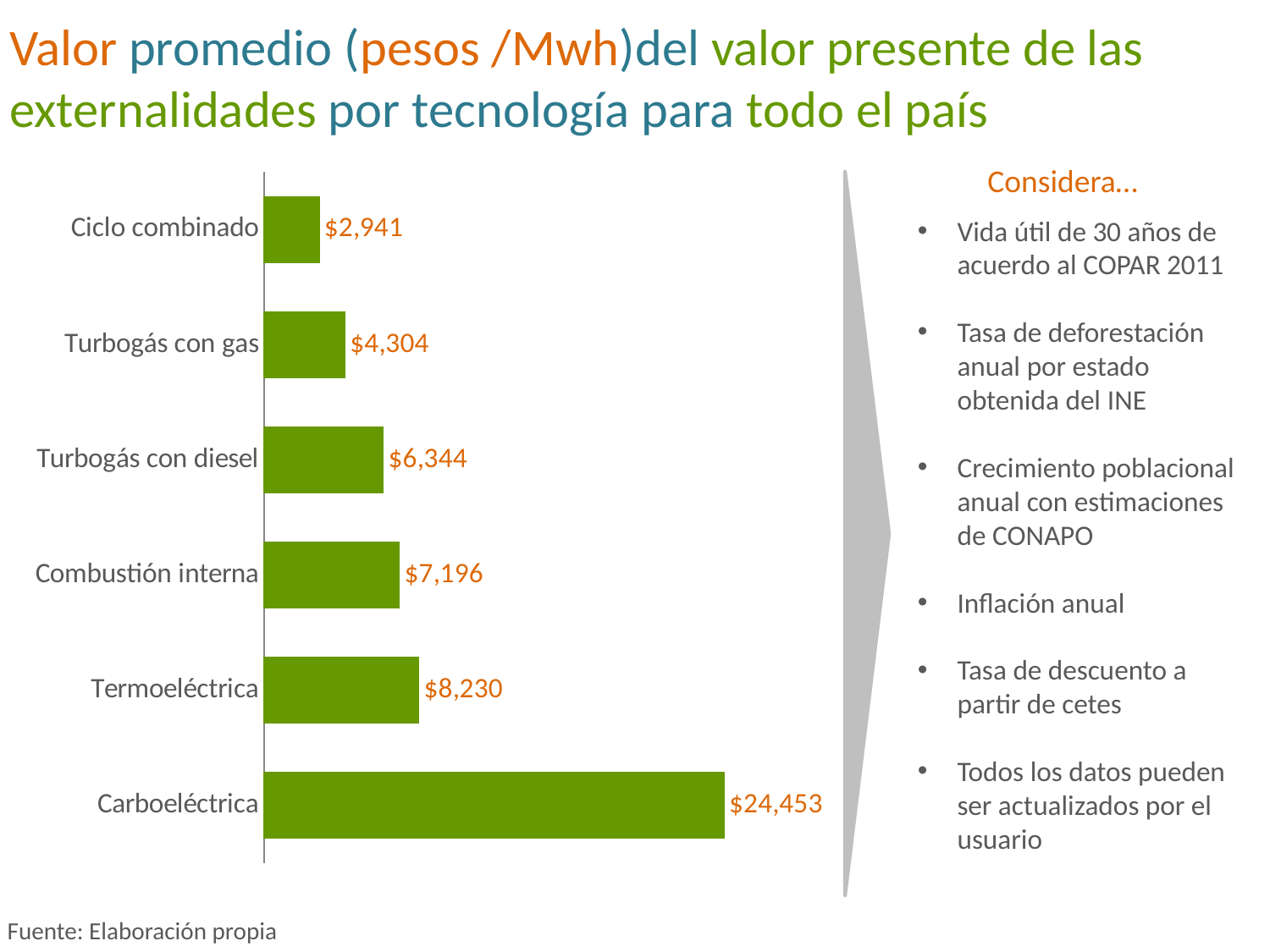
Which technology has the lowest value? Ciclo combinado What is the value for Carboeléctrica? $24,453 What colour are the bars in the chart? Green What is the value for Turbogás con diesel? $6,344 What is the value for Ciclo combinado? $2,941 What kind of chart is shown on the slide? Bar chart How many technologies are shown in the chart? 6 What is the value for Termoeléctrica? $8,230 What is the difference between the values for Carboeléctrica and Termoeléctrica? $16,223 What is the difference between the values for Turbogás con gas and Ciclo combinado? $1,363 Which is larger, the value for Combustión interna or the value for Turbogás con diesel? Combustión interna Which technology has the highest value? Carboeléctrica